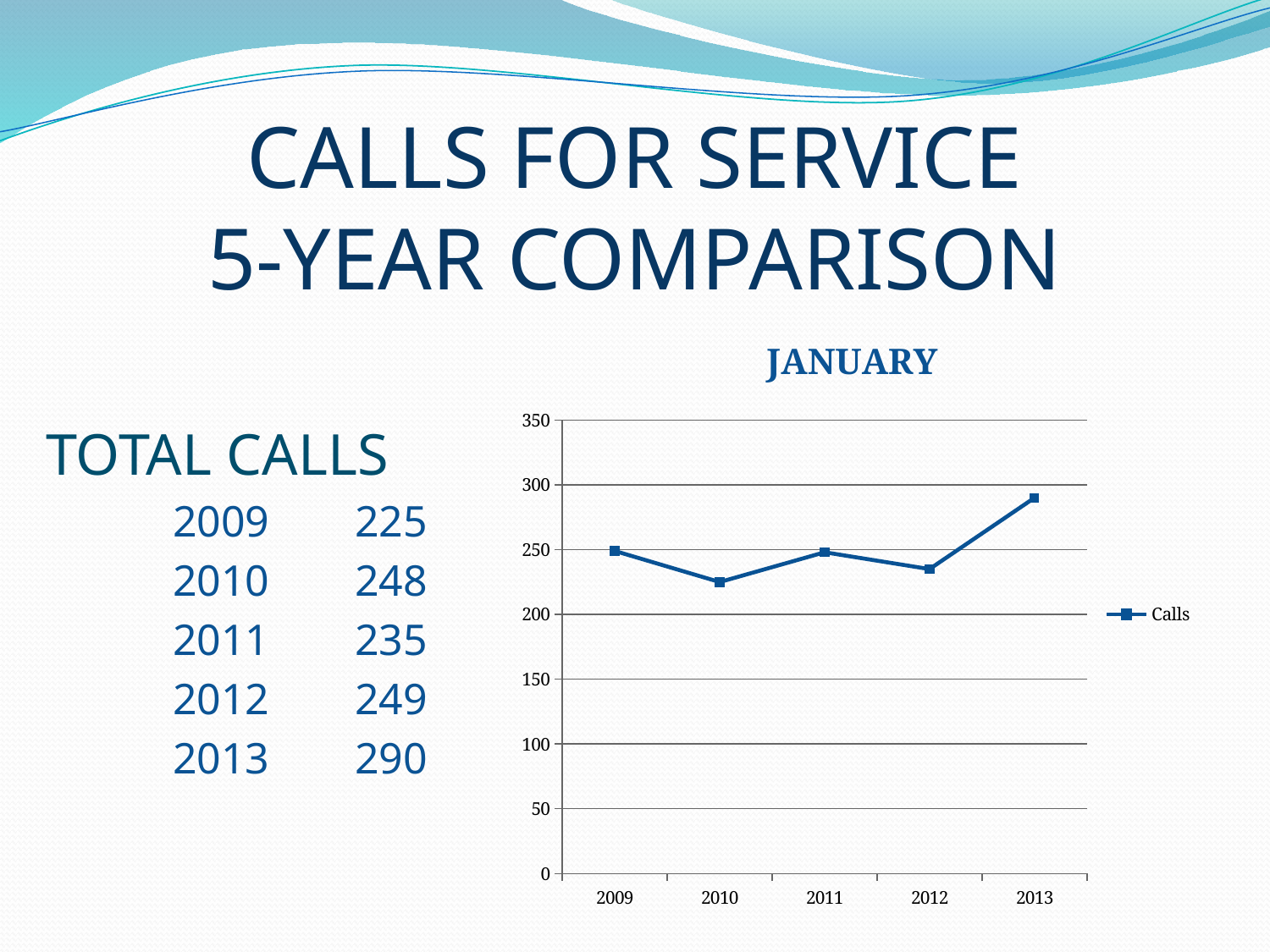
Is the value for 2010 greater or less than 250? less What is the title of the chart? JANUARY Which year has the larger value on the chart, 2009 or 2010? 2009 Does the line rise or fall from 2012 to 2013? rise How many years are plotted on the x axis of the chart? 5 What kind of chart is shown on the slide? line chart Is the value for 2013 greater or less than 300? less What is the name of the series shown in the chart legend? Calls How many series does the chart legend list? 1 Which year has the highest value on the chart? 2013 Is the value for 2013 greater or less than 250? greater Which year has the lowest value on the chart? 2010